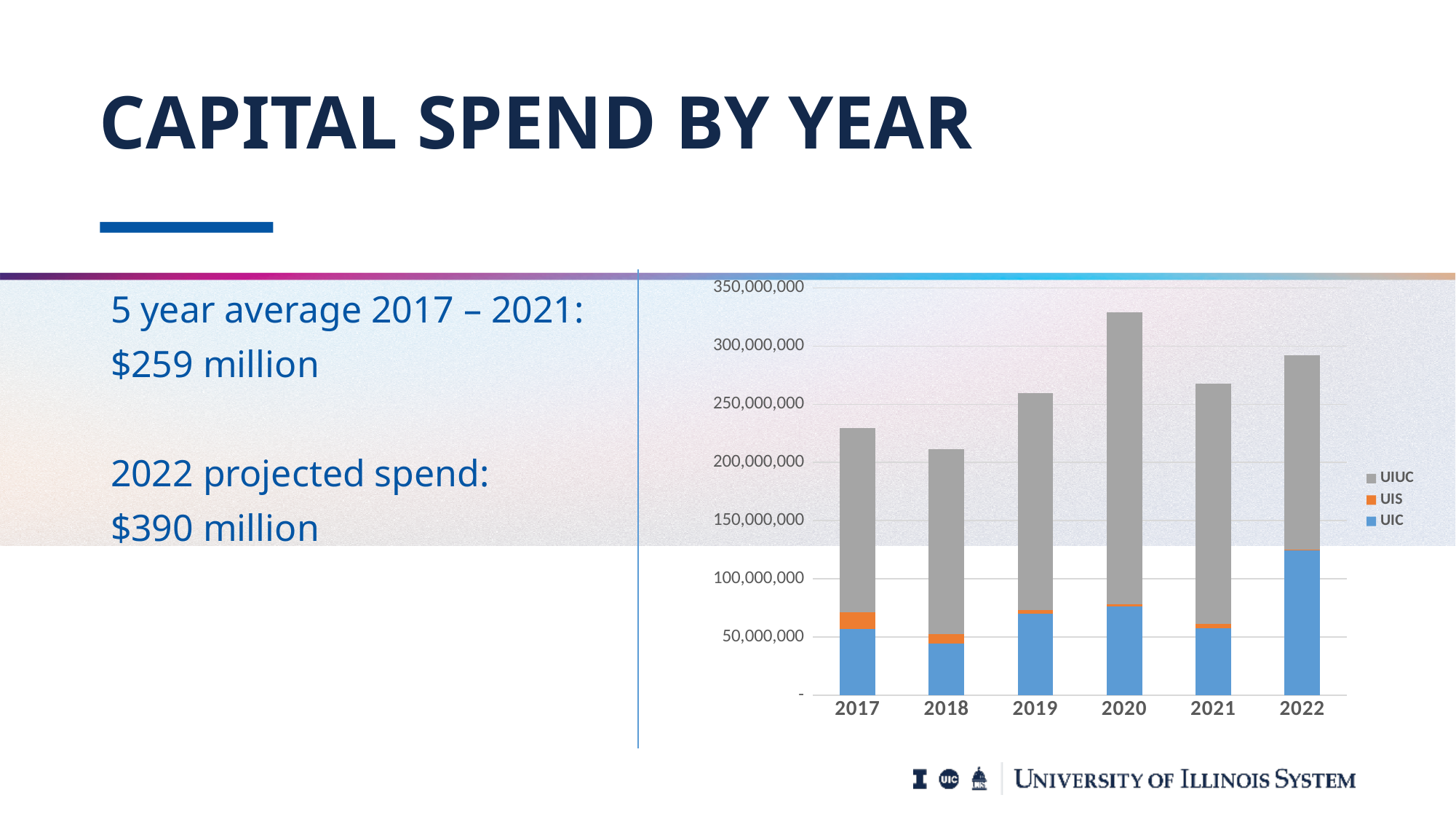
Which year has the larger total bar, 2021 or 2022? 2022 How many years are shown on the x axis of the chart? 6 Is the UIC value for 2022 greater or less than 100,000,000? greater How many series does the chart's legend list? 3 Is the total bar for 2018 greater or less than 250,000,000? less Which year has the larger UIC segment, 2020 or 2022? 2022 Which year has the lowest total capital spend in the chart? 2018 Which year has the highest total capital spend in the chart? 2020 Is the total bar for 2020 greater or less than 300,000,000? greater What kind of chart is shown on the slide? stacked bar chart Which series is shown in gray in the chart's legend? UIUC